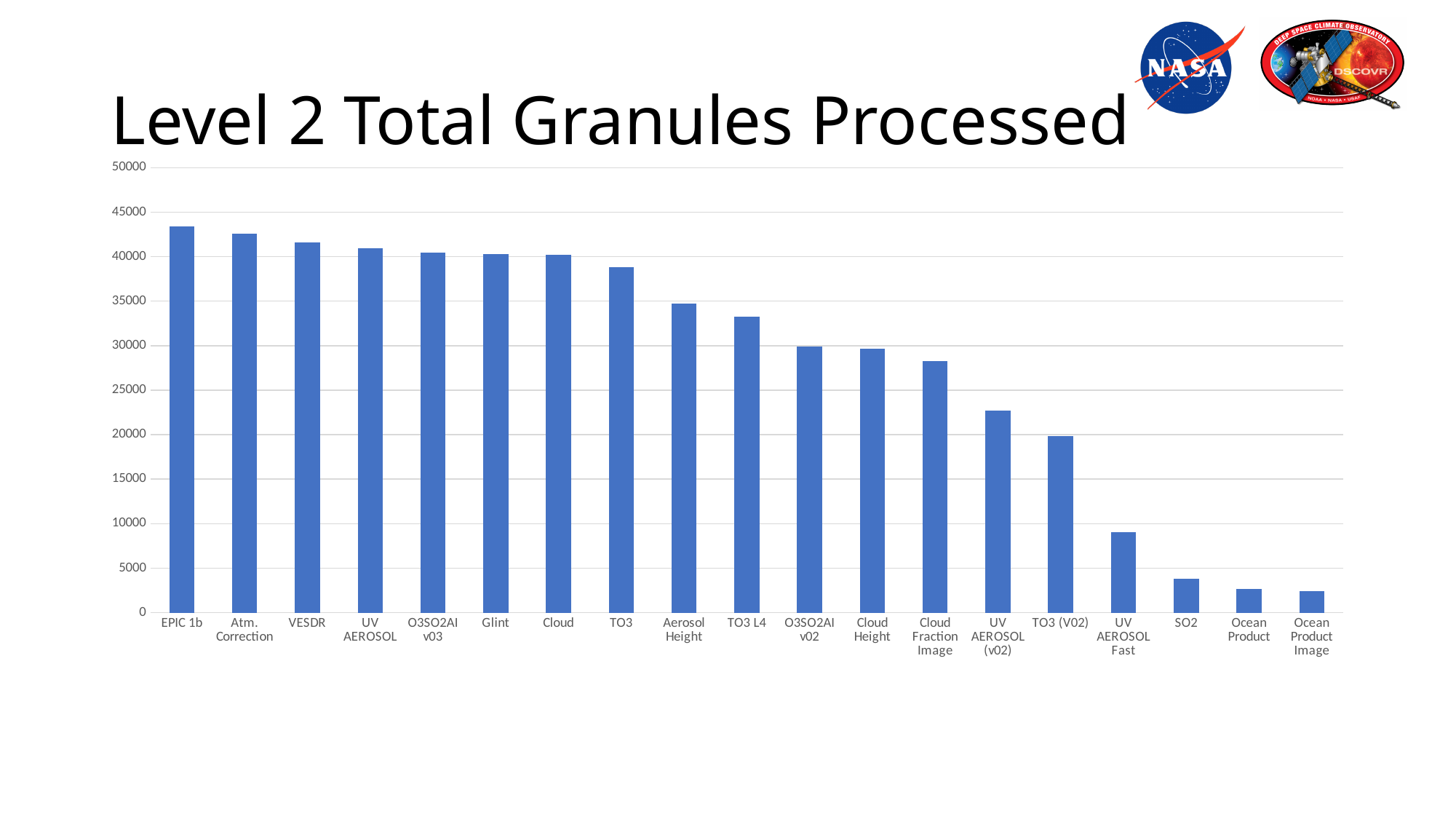
Is the value for TO3 L4 greater or less than 30000? greater What is the title of the chart? Level 2 Total Granules Processed Is the value for TO3 greater or less than 40000? less How many categories are plotted on the chart? 19 Is the value for UV AEROSOL Fast greater or less than 10000? less Which is larger, the value for Cloud Height or the value for Cloud Fraction Image? Cloud Height Do the values generally rise or fall from left to right along the x axis? Fall Which is larger, the value for VESDR or the value for TO3? VESDR Which category has the highest value? EPIC 1b What kind of chart is shown on the slide? Bar chart